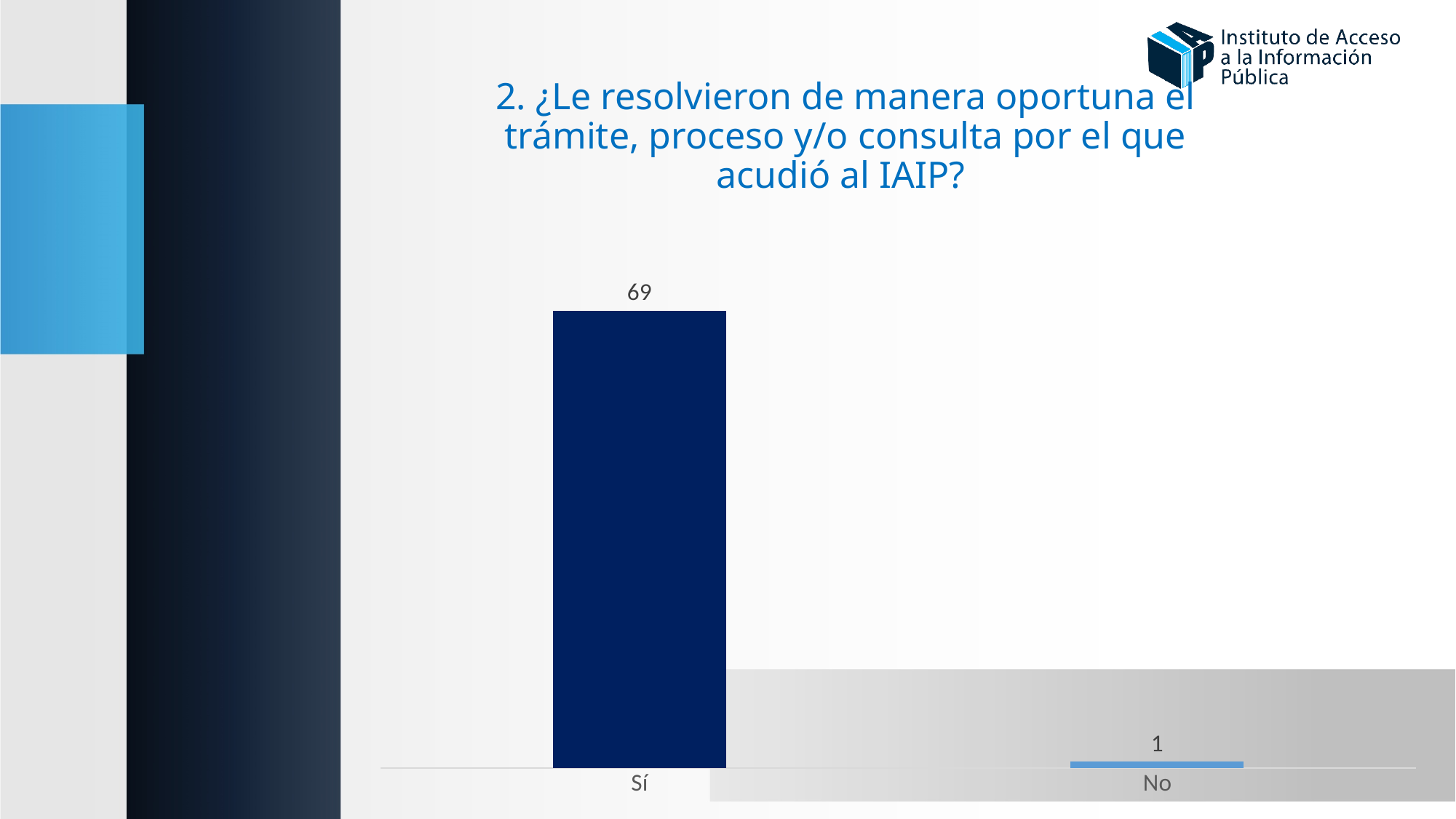
What kind of chart is shown on the slide? Bar chart What is the difference between the values for Sí and No? 68 What is the value for No? 1 What colour is the bar for Sí? Dark blue What is the title of the chart? 2. ¿Le resolvieron de manera oportuna el trámite, proceso y/o consulta por el que acudió al IAIP? How many categories are shown in the chart? 2 What is the total of the values for Sí and No? 70 What is the value for Sí? 69 Which is larger, the value for Sí or the value for No? Sí Which category has the highest value? Sí Which category has the lowest value? No